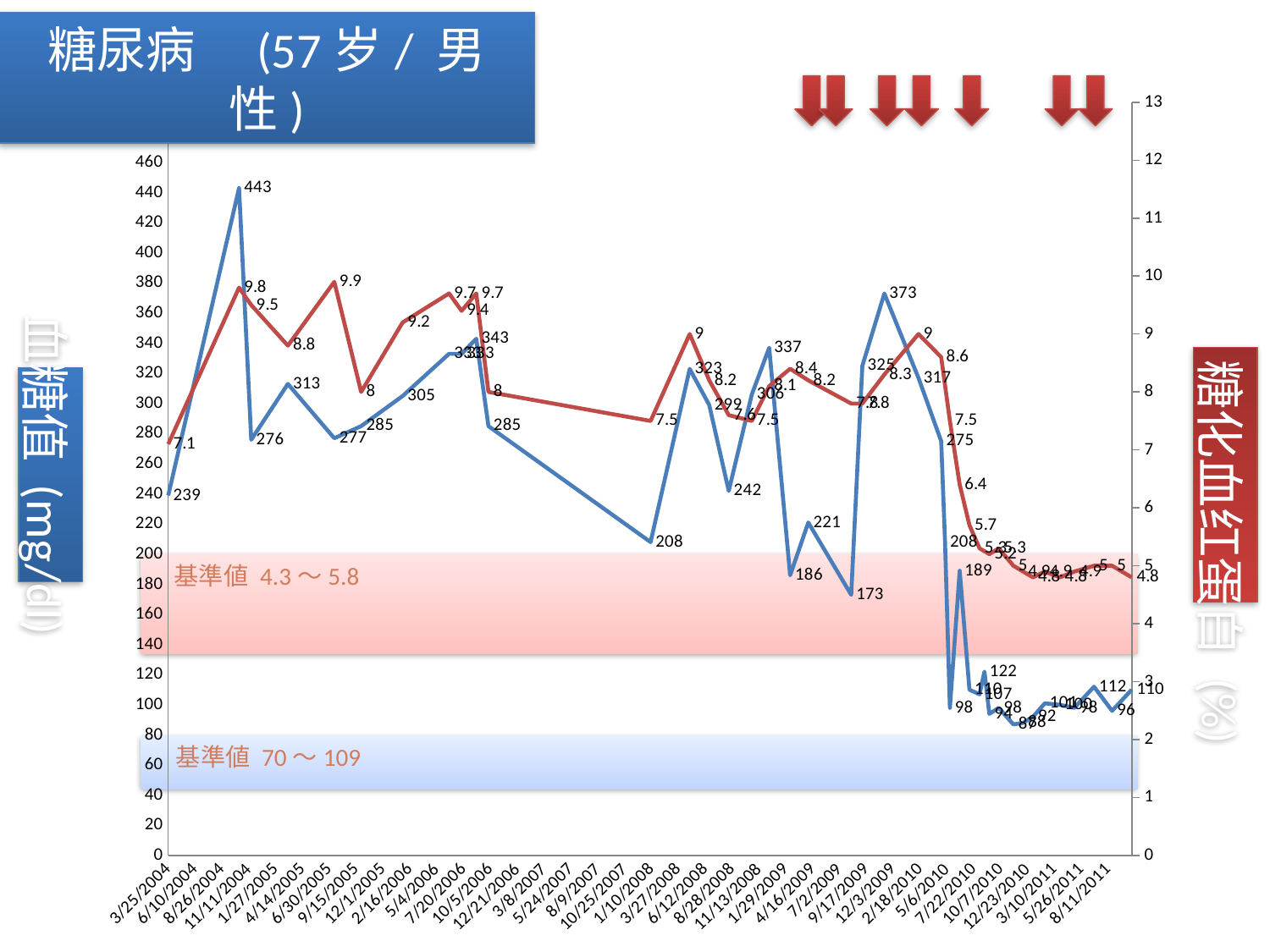
What is the first blood glucose value plotted on the blue line, at 3/25/2004? 239 How many data series are plotted on the chart? 2 What is the difference between the highest blood glucose value (443) and the first value (239)? 204 What kind of chart is shown on the slide? line chart What is the highest HbA1c (糖化血红蛋白) value plotted on the red line? 9.9 Overall, do the HbA1c values on the red line rise or fall from 2010 to 2011? fall What is the title of the left vertical axis? 血糖値 (mg/dl) What reference range (基準値) is shown in the blue shaded band? 70～109 What is the first HbA1c value plotted on the red line, at 3/25/2004? 7.1 Which is larger, the blood glucose peak of 443 or the later peak of 373? 443 What is the last HbA1c value plotted on the red line? 4.8 What is the highest blood glucose (血糖値) value plotted on the blue line? 443